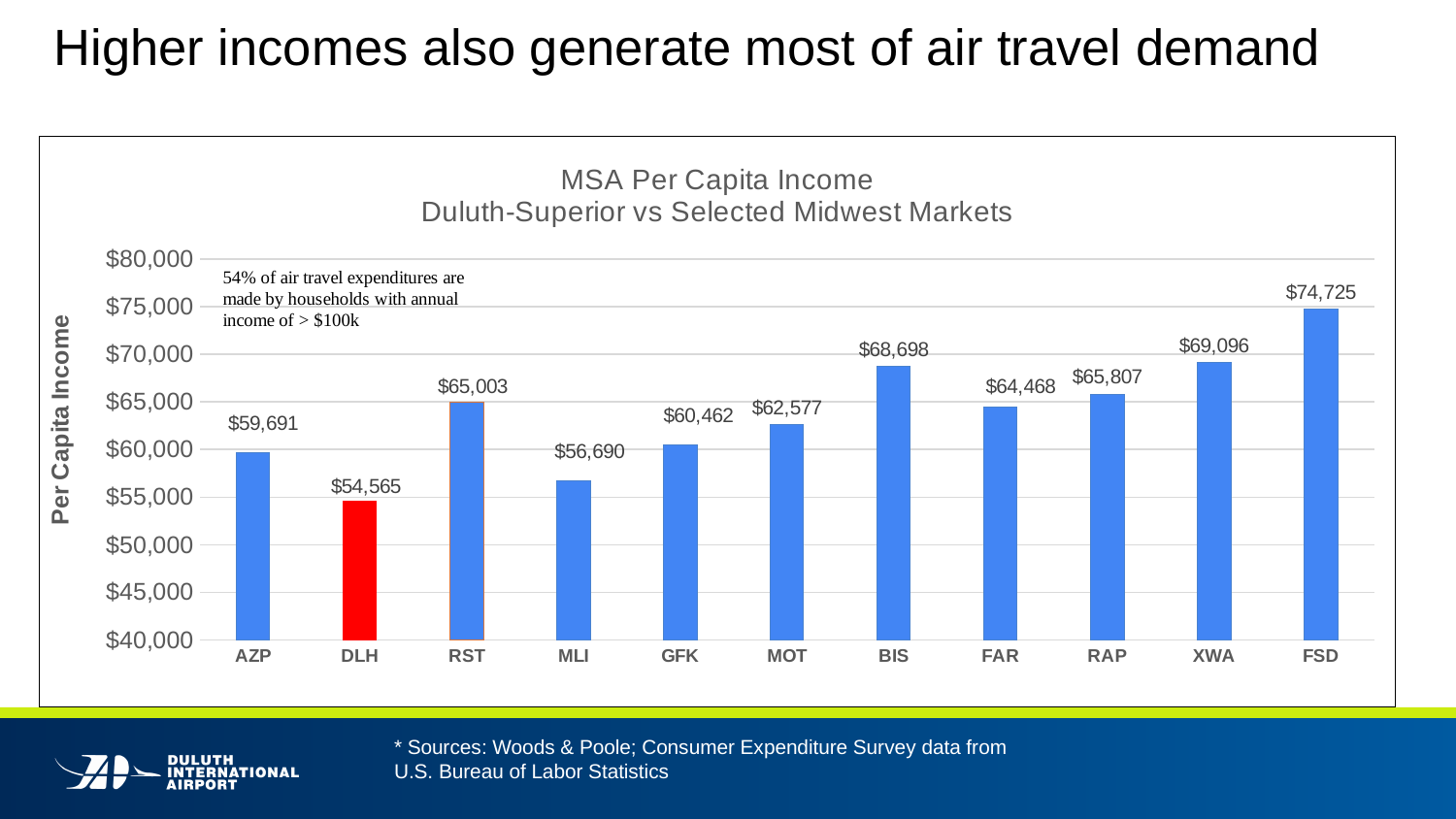
What type of chart is shown on the slide? bar chart What is the per capita income shown for DLH? $54,565 What is the difference in per capita income between AZP and DLH? $5,126 What is the per capita income shown for FSD? $74,725 Which market has the highest per capita income on the chart? FSD Which has a higher per capita income, RST or RAP? RAP Is the per capita income for MLI greater or less than $60,000? less How many markets are shown on the chart? 11 What is the difference in per capita income between FSD and DLH? $20,160 What is the per capita income shown for BIS? $68,698 Which market has the lowest per capita income on the chart? DLH Which bar on the chart is coloured red? DLH